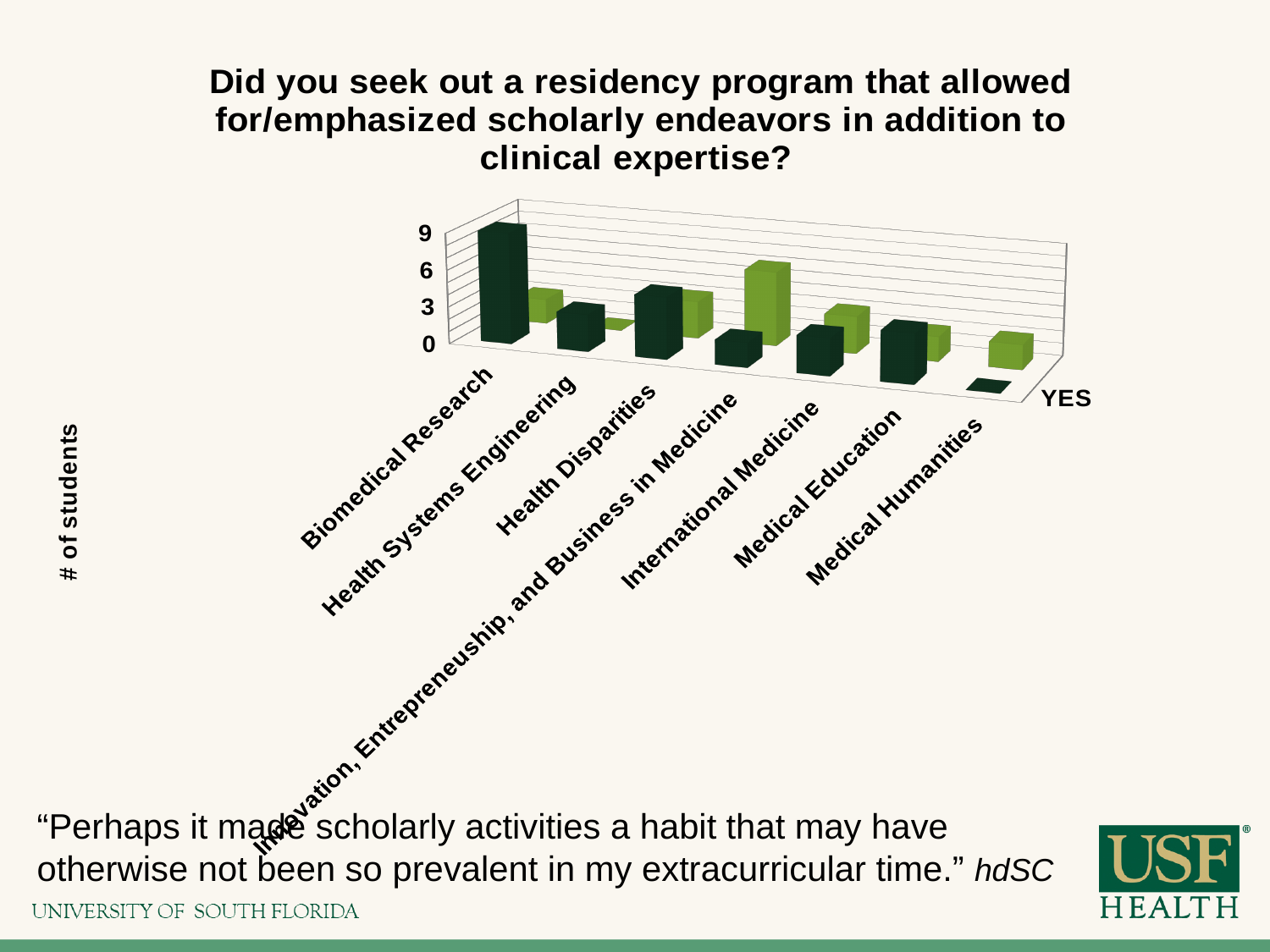
What is the highest value shown on the vertical axis of the chart? 9 Which category has the tallest dark green bar? Biomedical Research What kind of chart is shown on the slide? Bar chart Is the dark green bar for Medical Humanities greater or less than 3? less Is the dark green bar for Biomedical Research greater or less than 6? greater Which category has the lowest dark green bar? Medical Humanities Which is larger: the dark green bar for Biomedical Research or the dark green bar for Health Disparities? Biomedical Research How many categories are shown along the x axis of the chart? 7 What is the label on the vertical axis of the chart? # of students